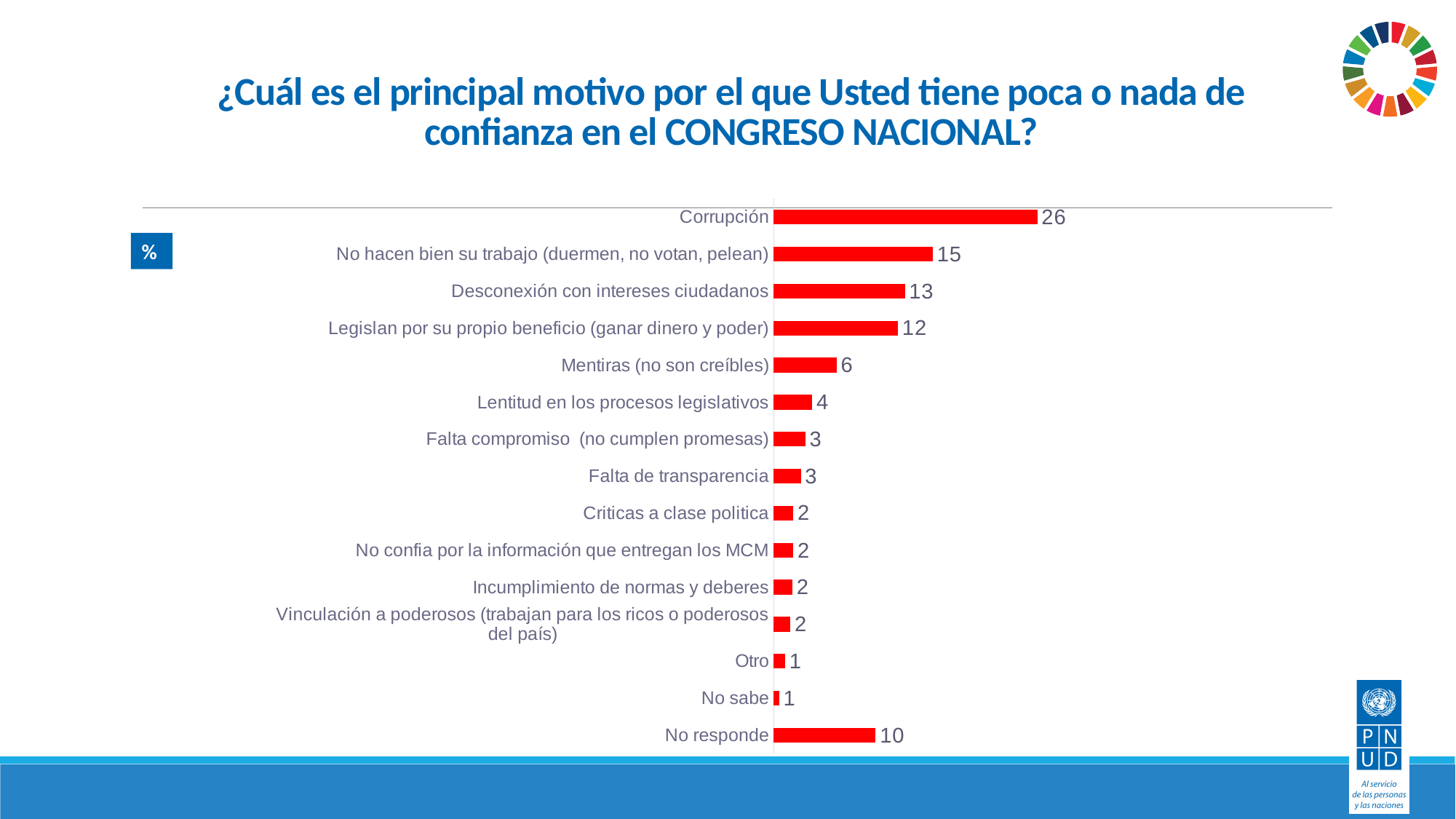
Which is larger, the value for No responde or the value for Mentiras (no son creíbles)? No responde What colour are the bars in the chart? Red What is the difference between the values for Desconexión con intereses ciudadanos and Legislan por su propio beneficio (ganar dinero y poder)? 1 What value is shown for Mentiras (no son creíbles)? 6 Which category has the highest value? Corrupción What kind of chart is shown on the slide? Bar chart What value is shown for No responde? 10 What value is shown for Lentitud en los procesos legislativos? 4 How many categories are shown in the chart? 15 What is the difference between the values for Corrupción and No hacen bien su trabajo (duermen, no votan, pelean)? 11 Which is larger, the value for Falta de transparencia or the value for Lentitud en los procesos legislativos? Lentitud en los procesos legislativos What value is shown for Corrupción? 26